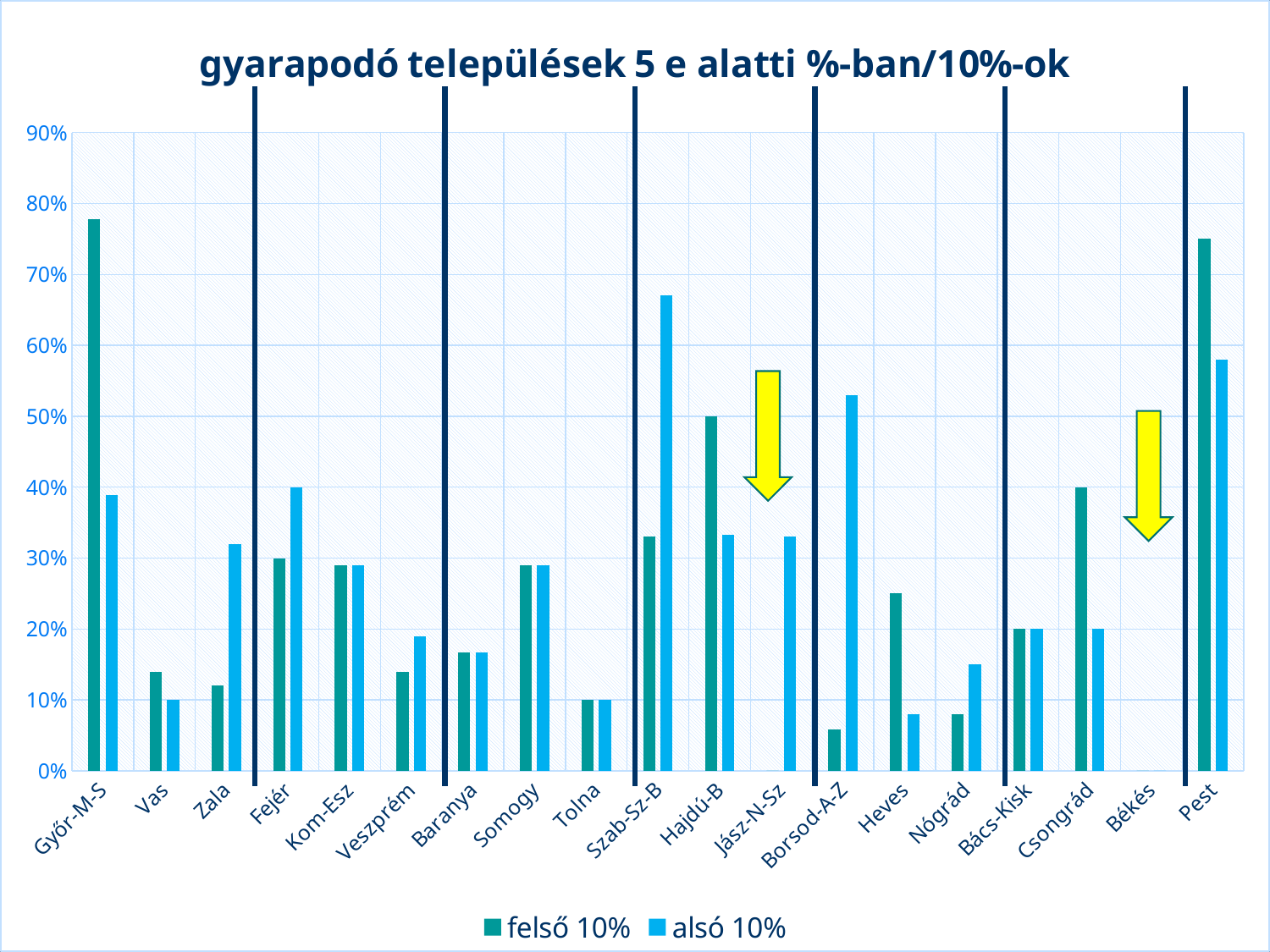
How many series does the legend list? 2 Is the alsó 10% value for Borsod-A-Z greater or less than 40%? greater For Pest, which series has the larger value, felső 10% or alsó 10%? felső 10% Is the felső 10% value for Nógrád greater or less than 10%? less Which series is shown in the lighter blue colour? alsó 10% Which category has the highest value for the alsó 10% series? Szab-Sz-B Is the felső 10% value for Győr-M-S greater or less than 70%? greater What kind of chart is shown on the slide? bar chart How many categories are shown on the x axis? 19 What is the title of the chart? gyarapodó települések 5 e alatti %-ban/10%-ok For Szab-Sz-B, which series has the larger value, felső 10% or alsó 10%? alsó 10%